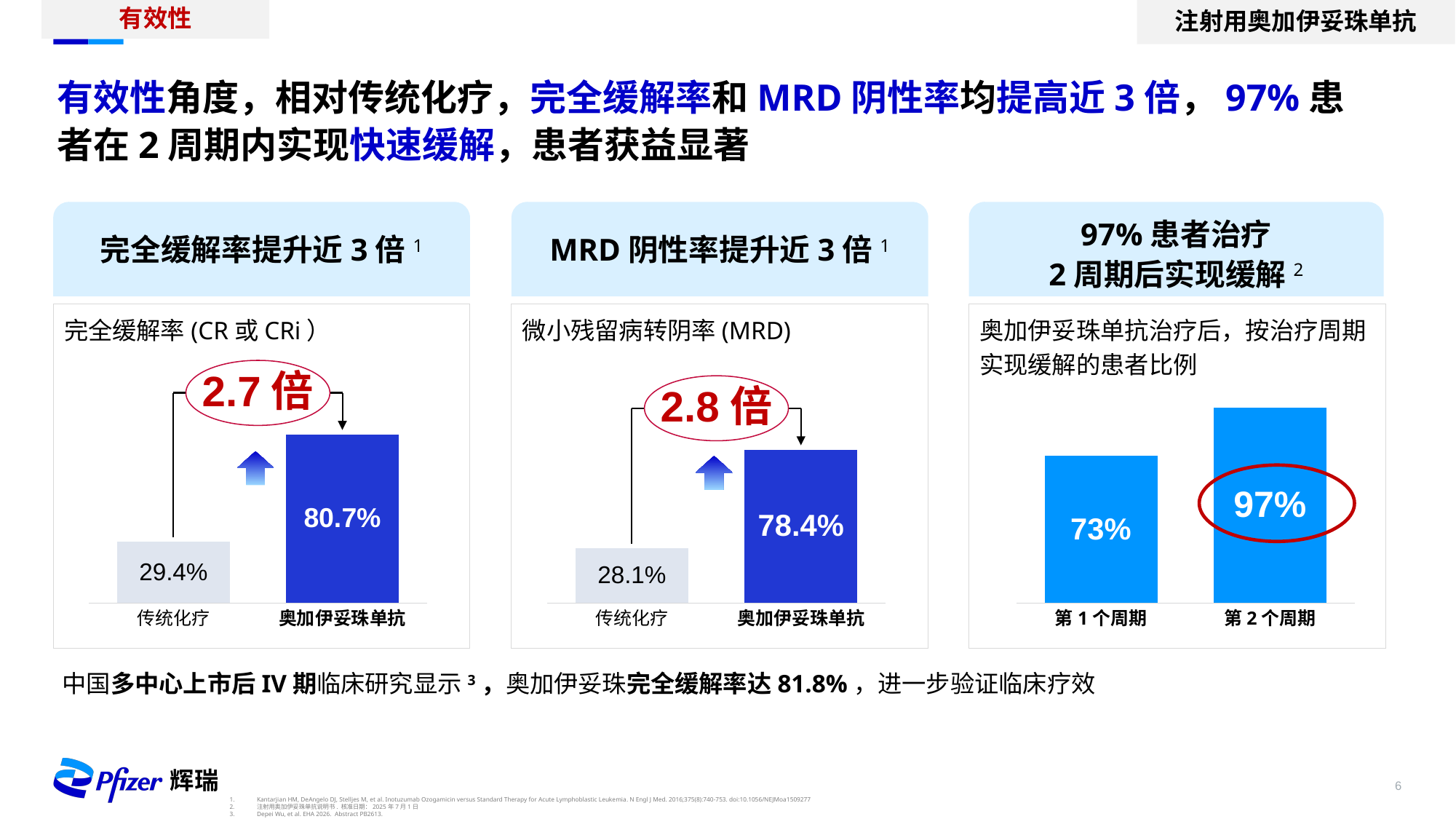
In the right chart (按治疗周期实现缓解的患者比例), what is the value for 第 2 个周期? 97% In the middle chart (MRD), what is the value for 奥加伊妥珠单抗? 78.4% What type of chart is the right chart (按治疗周期实现缓解的患者比例)? Bar chart In the left chart (完全缓解率), what is the difference between 奥加伊妥珠单抗 and 传统化疗? 51.3 percentage points In the left chart (完全缓解率), what is the value for 传统化疗? 29.4% In the middle chart (MRD), which category has the higher value? 奥加伊妥珠单抗 How many bars are in the left chart (完全缓解率)? 2 In the right chart (按治疗周期实现缓解的患者比例), by how much does the value increase from 第 1 个周期 to 第 2 个周期? 24 percentage points In the middle chart (MRD), what is the value for 传统化疗? 28.1% In the left chart (完全缓解率), what is the value for 奥加伊妥珠单抗? 80.7% In the right chart (按治疗周期实现缓解的患者比例), what is the value for 第 1 个周期? 73% In the middle chart (MRD), what is the difference between 奥加伊妥珠单抗 and 传统化疗? 50.3 percentage points